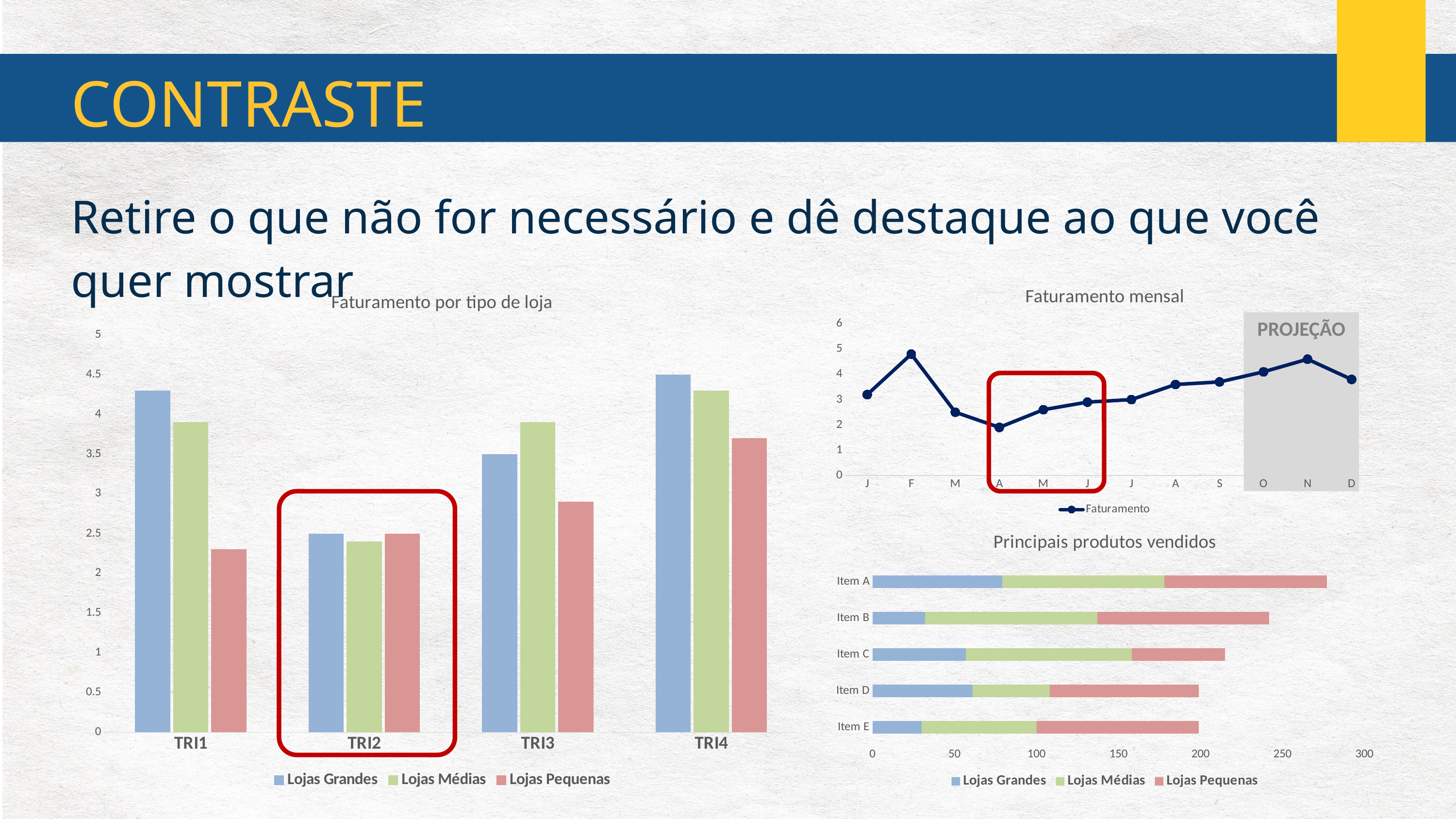
In the "Faturamento mensal" chart, which month has the lowest value? A In the "Faturamento por tipo de loja" chart, is the value for Lojas Grandes in TRI1 greater or less than 4? greater In the "Principais produtos vendidos" chart, how many items are listed? 5 In the "Faturamento por tipo de loja" chart, how many series does the legend list? 3 In the "Faturamento mensal" chart, which month has the highest value? F What kind of chart is "Faturamento mensal"? line chart In the "Faturamento por tipo de loja" chart, in TRI3 which is larger, Lojas Médias or Lojas Pequenas? Lojas Médias In the "Faturamento por tipo de loja" chart, how many categories are shown on the x axis? 4 In the "Faturamento por tipo de loja" chart, which quarter has the lowest value for Lojas Grandes? TRI2 What kind of chart is "Faturamento por tipo de loja"? bar chart In the "Faturamento por tipo de loja" chart, is the value for Lojas Pequenas in TRI1 greater or less than 2.5? less In the "Principais produtos vendidos" chart, which item has the longest total bar? Item A